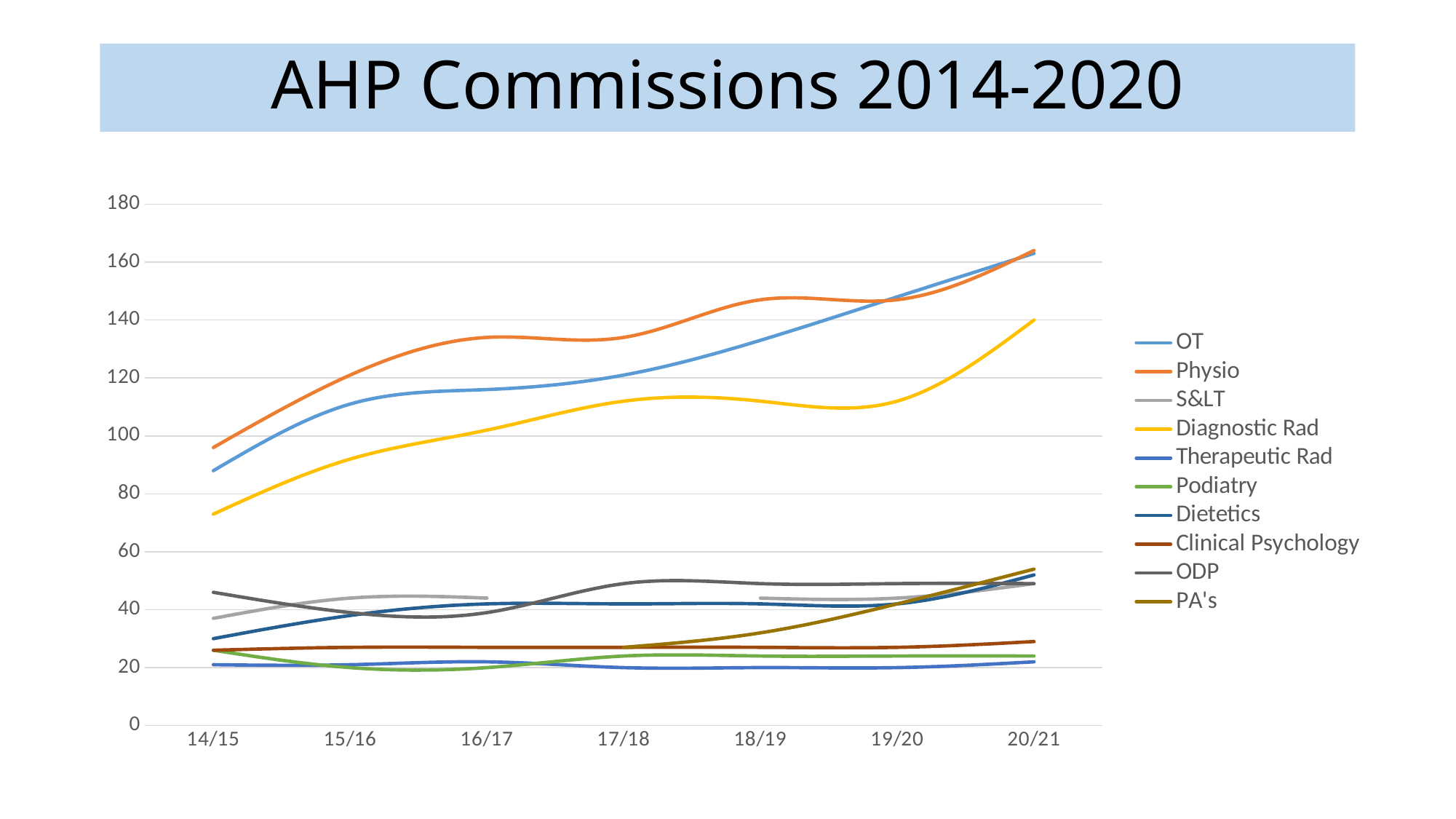
Is the value for PA's in 20/21 greater or less than 40? greater What is the title of the chart? AHP Commissions 2014-2020 Is the value for Physio in 14/15 greater or less than 80? greater How many series does the legend list? 10 Which series has the highest value in 14/15? Physio What kind of chart is shown on the slide? line chart How many academic years are shown along the x axis? 7 Is the value for OT in 14/15 greater or less than 100? less In 20/21, which is larger, Diagnostic Rad or ODP? Diagnostic Rad Does the OT line rise or fall from 14/15 to 20/21? rise